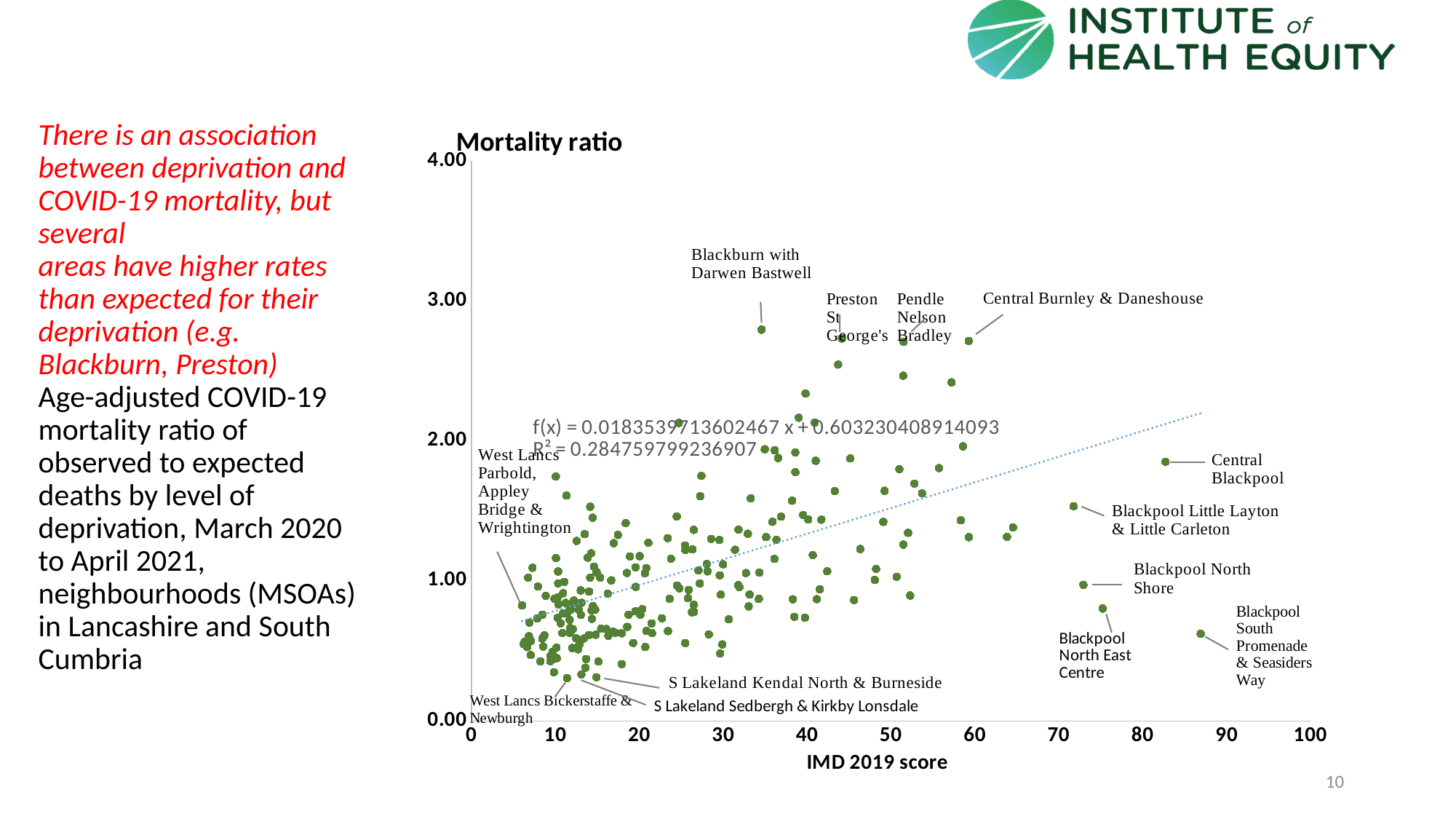
Is the mortality ratio for Central Blackpool greater or less than 2.00? less Is the mortality ratio for Blackpool South Promenade & Seasiders Way greater or less than 1.00? less What is the label on the x axis of the chart? IMD 2019 score Is the IMD 2019 score for Blackpool North Shore greater or less than 60? greater Which has the higher mortality ratio, Blackburn with Darwen Bastwell or Central Blackpool? Blackburn with Darwen Bastwell What is the title of the chart? Mortality ratio What R² value is printed on the chart for the trendline? 0.284759799236907 Which has the higher mortality ratio, Central Blackpool or Blackpool South Promenade & Seasiders Way? Central Blackpool Does the dotted trendline rise or fall as the IMD 2019 score increases? Rises What kind of chart is shown on the slide? Scatter chart